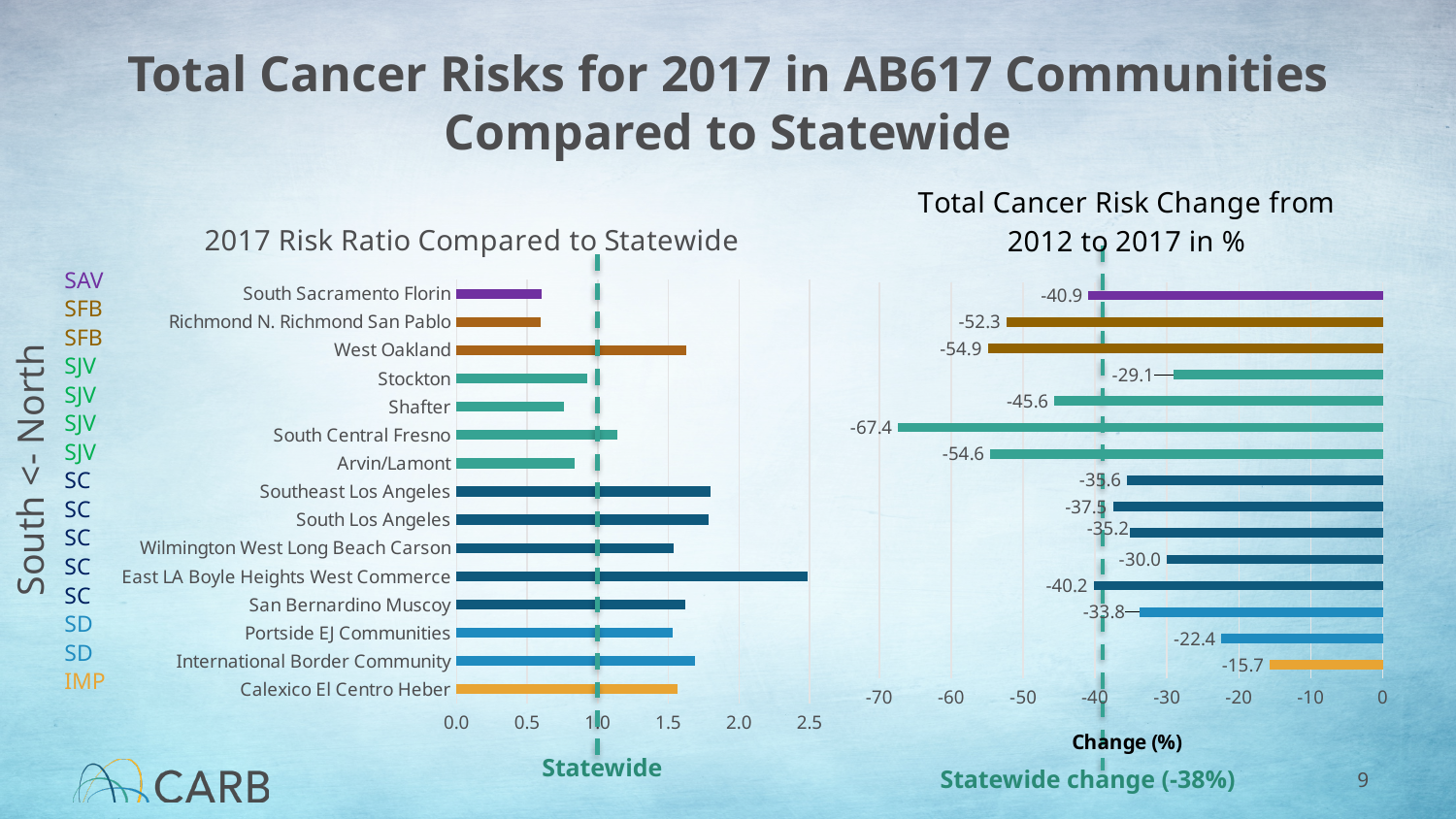
What statewide change value is noted below the 'Total Cancer Risk Change from 2012 to 2017 in %' chart? -38% In the 'Total Cancer Risk Change from 2012 to 2017 in %' chart, what is the value for West Oakland? -54.9 In the 'Total Cancer Risk Change from 2012 to 2017 in %' chart, what is the value for Calexico El Centro Heber? -15.7 In the 'Total Cancer Risk Change from 2012 to 2017 in %' chart, what is the difference in percentage points between the values for Richmond N. Richmond San Pablo (-52.3) and South Sacramento Florin (-40.9)? 11.4 In the '2017 Risk Ratio Compared to Statewide' chart, which has the larger risk ratio: East LA Boyle Heights West Commerce or South Sacramento Florin? East LA Boyle Heights West Commerce In the '2017 Risk Ratio Compared to Statewide' chart, is the value for Shafter greater or less than 1.0? less In the 'Total Cancer Risk Change from 2012 to 2017 in %' chart, which community shows the largest percentage decrease? South Central Fresno How many communities are listed in the '2017 Risk Ratio Compared to Statewide' chart? 15 In the 'Total Cancer Risk Change from 2012 to 2017 in %' chart, what is the value for South Central Fresno? -67.4 In the 'Total Cancer Risk Change from 2012 to 2017 in %' chart, which community shows the smallest percentage decrease? Calexico El Centro Heber What kind of chart is the '2017 Risk Ratio Compared to Statewide' chart? Bar chart In the '2017 Risk Ratio Compared to Statewide' chart, is the value for East LA Boyle Heights West Commerce greater or less than 2.0? greater